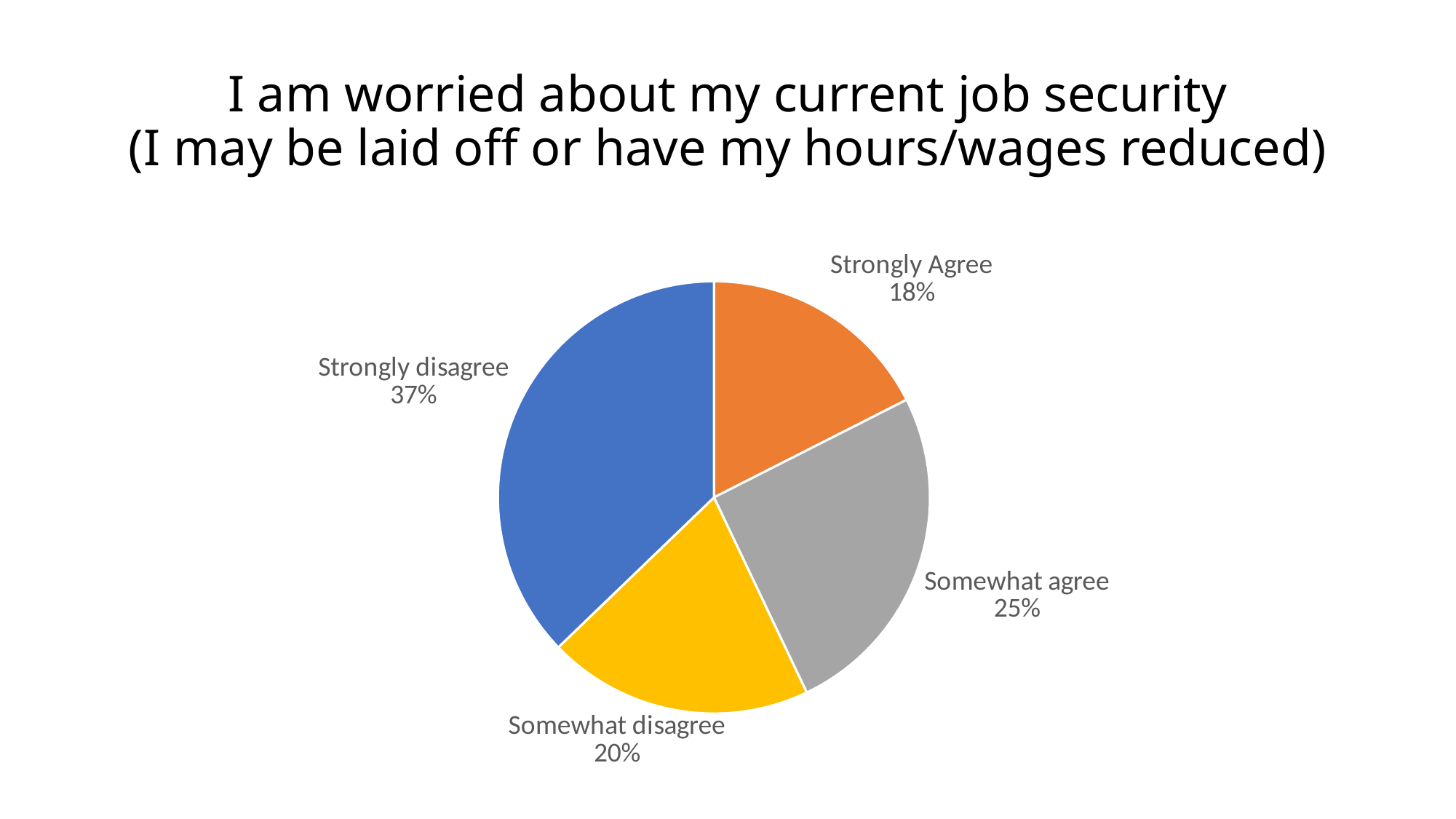
What share of the pie is labelled Strongly Agree? 18% What is the difference in percentage points between Strongly disagree and Strongly Agree? 19 Which is larger, the Somewhat agree slice or the Somewhat disagree slice? Somewhat agree What kind of chart is shown on the slide? Pie chart What share of the pie is labelled Somewhat disagree? 20% What is the difference in percentage points between Somewhat agree and Somewhat disagree? 5 What share of the pie is labelled Strongly disagree? 37% How many slices does the pie chart have? 4 Which response has the largest slice of the pie? Strongly disagree What share of the pie is labelled Somewhat agree? 25% Which response has the smallest slice of the pie? Strongly Agree What colour is the Strongly disagree slice? Blue